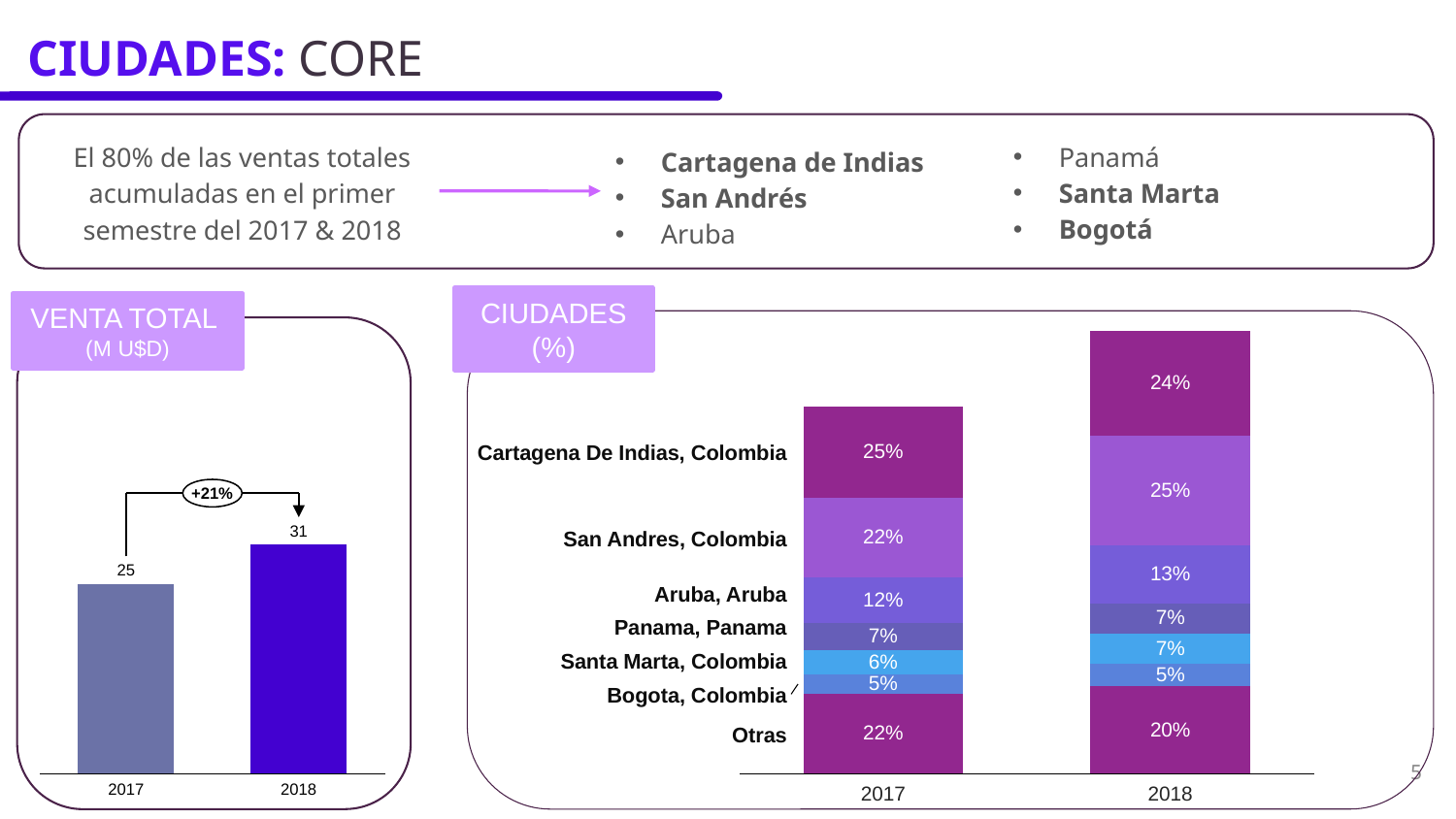
In the CIUDADES (%) chart, what is the difference between the Santa Marta, Colombia share in 2018 and in 2017? 1% In the CIUDADES (%) chart, is the share for Aruba, Aruba larger in 2017 or 2018? 2018 In the CIUDADES (%) chart, which city has the smallest share in 2017? Bogota, Colombia In the CIUDADES (%) chart, what is the share for Otras in 2018? 20% What kind of chart is the VENTA TOTAL (M U$D) chart? bar chart In the CIUDADES (%) chart, what is the share for San Andres, Colombia in 2018? 25% In the VENTA TOTAL (M U$D) chart, what percentage change is shown between 2017 and 2018? +21% In the CIUDADES (%) chart, what is the share for Cartagena De Indias, Colombia in 2017? 25% In the VENTA TOTAL (M U$D) chart, what is the value for 2017? 25 In the VENTA TOTAL (M U$D) chart, what is the difference between the 2018 and 2017 values? 6 In the VENTA TOTAL (M U$D) chart, what is the value for 2018? 31 In the CIUDADES (%) chart, how many segments make up each stacked bar? 7